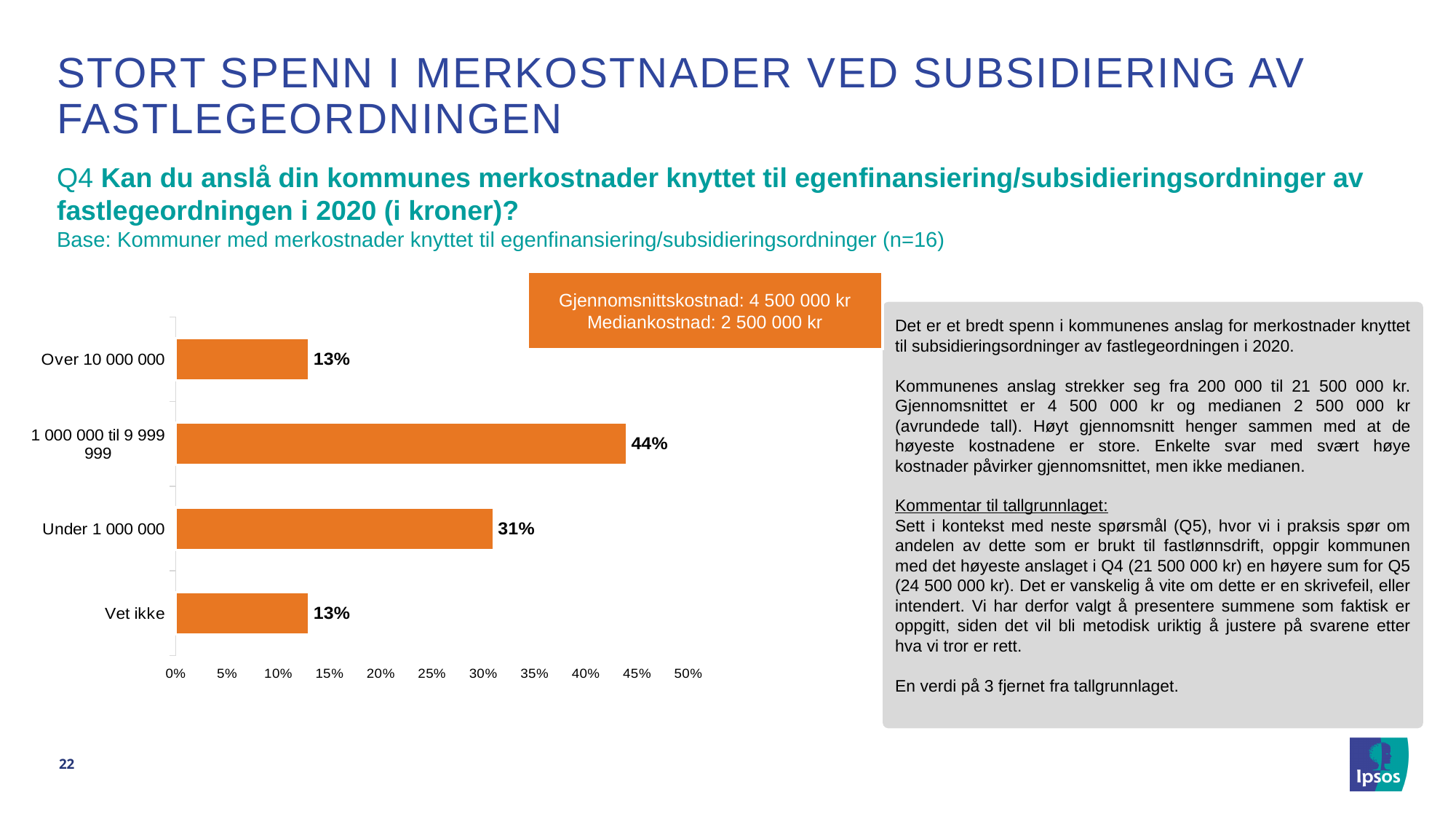
What is the value for '1 000 000 til 9 999 999'? 44% What is the average cost (Gjennomsnittskostnad) stated in the box above the chart? 4 500 000 kr What is the value for 'Under 1 000 000'? 31% What is the difference between the values for '1 000 000 til 9 999 999' and 'Under 1 000 000'? 13% What is the median cost (Mediankostnad) stated in the box above the chart? 2 500 000 kr Which is larger, the value for 'Under 1 000 000' or the value for 'Over 10 000 000'? Under 1 000 000 How many categories are shown in the chart? 4 Is the value for 'Under 1 000 000' greater or less than 25%? greater Which category has the highest value? 1 000 000 til 9 999 999 What is the value for 'Over 10 000 000'? 13% What is the value for 'Vet ikke'? 13% What kind of chart is shown on the slide? bar chart